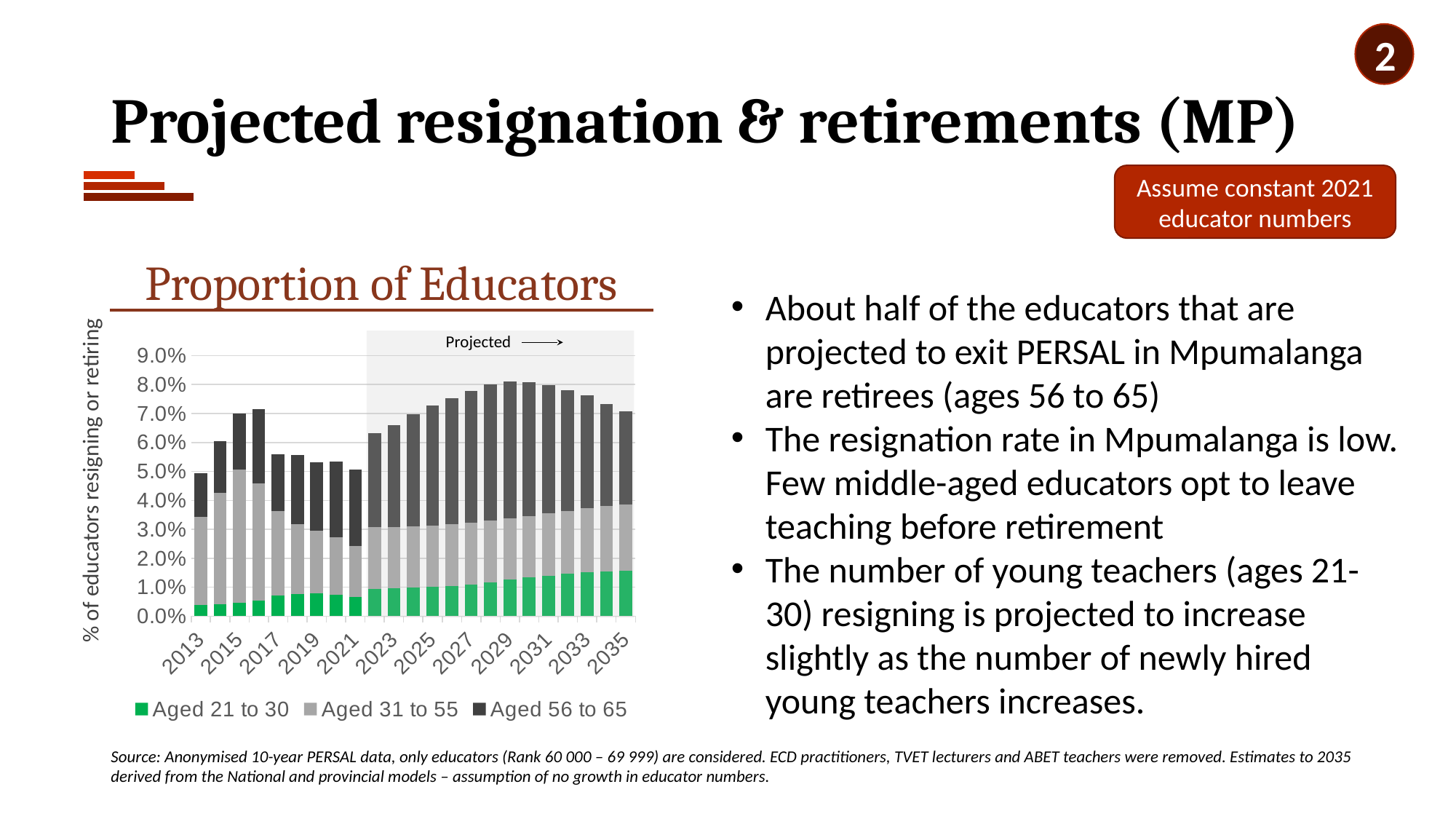
Does the total stacked bar rise or fall from 2021 to 2029? Rise What kind of chart is shown on the slide? Stacked bar chart Which year has the larger total stacked bar, 2013 or 2029? 2029 Does the Aged 21 to 30 series rise or fall from 2023 to 2035? Rise What is the title of the chart? Proportion of Educators Is the total value of the stacked bar for 2017 greater or less than 5.0%? greater Is the total value of the stacked bar for 2029 greater or less than 7.0%? greater Is the total value of the stacked bar for 2013 greater or less than 6.0%? less How many years (bars) are plotted in the chart? 23 How many series does the chart legend list? 3 What are the three series listed in the chart legend? Aged 21 to 30, Aged 31 to 55, Aged 56 to 65